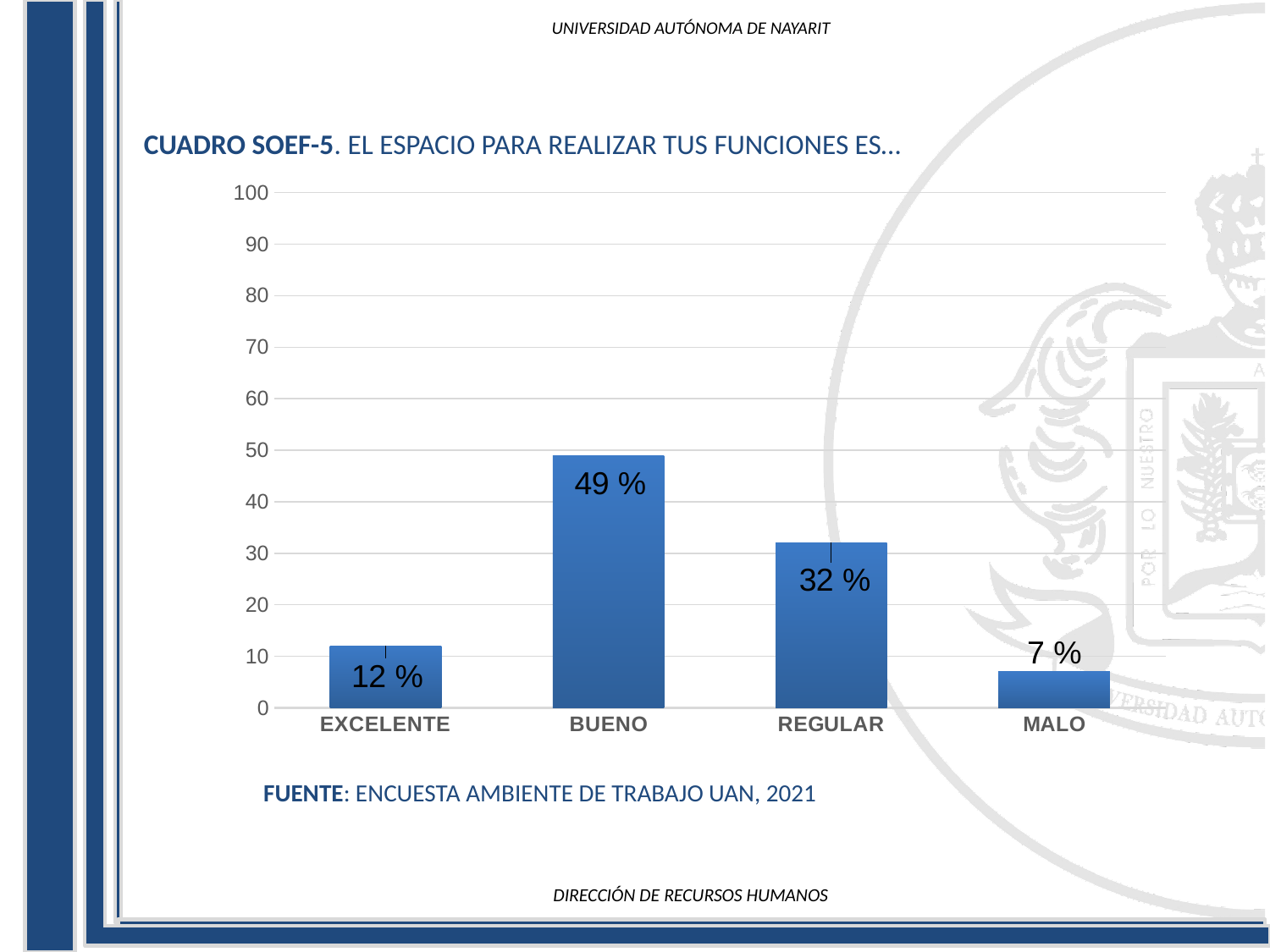
What is the value for BUENO? 49 % What is the value for REGULAR? 32 % Is the value for BUENO greater or less than 40? greater Which category has the highest value? BUENO What kind of chart is shown on the slide? bar chart What is the difference between the values for BUENO and REGULAR? 17 % What is the title of the chart? CUADRO SOEF-5. EL ESPACIO PARA REALIZAR TUS FUNCIONES ES… Which is larger, the value for EXCELENTE or the value for REGULAR? REGULAR How many categories are shown on the x axis? 4 Which category has the lowest value? MALO What is the value for EXCELENTE? 12 % What is the value for MALO? 7 %